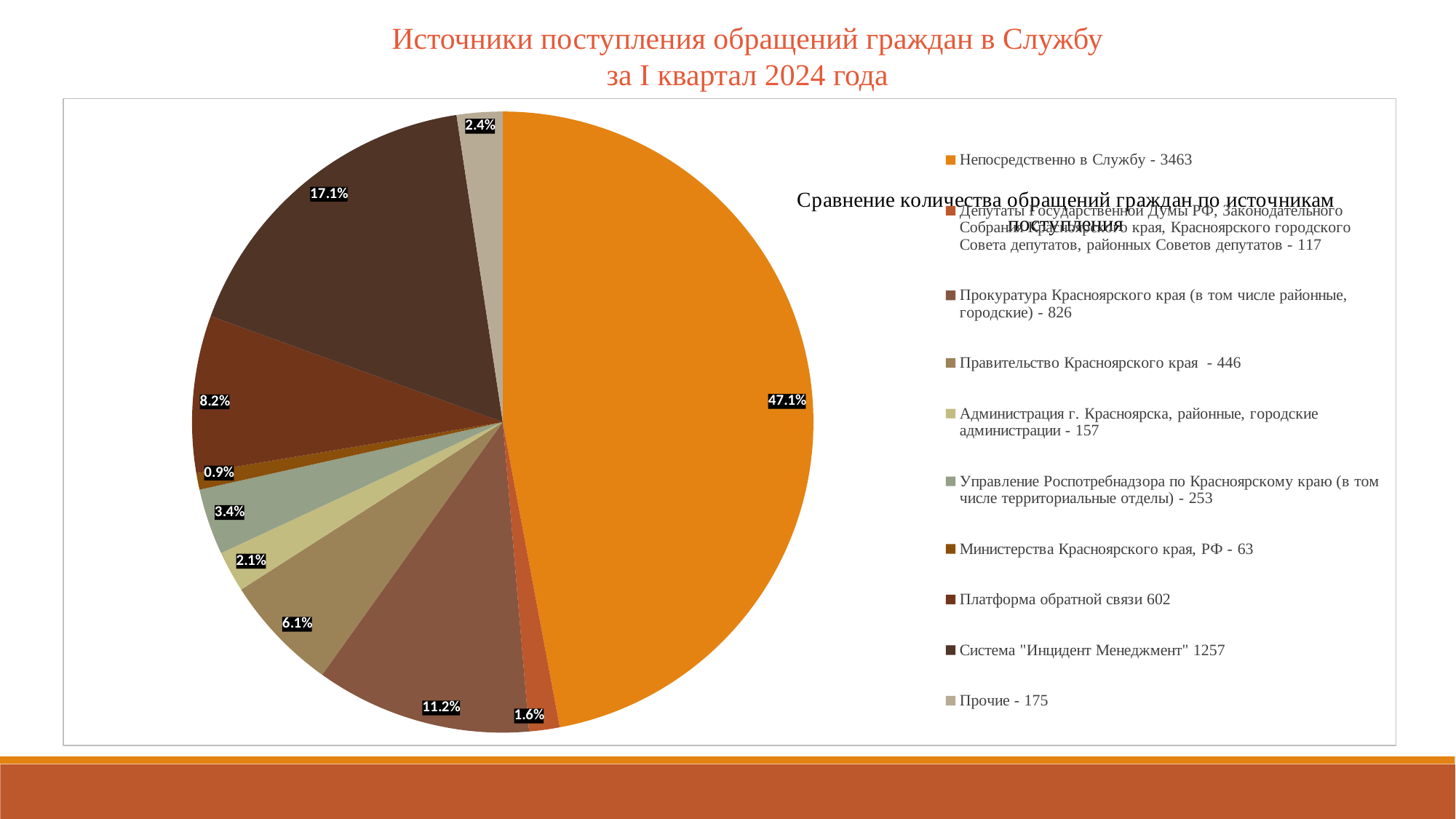
What share of the pie does "Непосредственно в Службу" account for? 47.1% What kind of chart is shown on the slide? Pie chart What share of the pie does "Прокуратура Красноярского края (в том числе районные, городские)" account for? 11.2% According to the legend, how many appeals came through "Платформа обратной связи"? 602 What share of the pie does "Система "Инцидент Менеджмент"" account for? 17.1% Which slice is larger: "Управление Роспотребнадзора по Красноярскому краю" or "Администрация г. Красноярска, районные, городские администрации"? Управление Роспотребнадзора по Красноярскому краю Which source has the smallest slice of the pie? Министерства Красноярского края, РФ What is the difference in percentage points between the "Платформа обратной связи" slice (8.2%) and the "Правительство Красноярского края" slice (6.1%)? 2.1 According to the legend, how many appeals are listed for "Прочие"? 175 How many slices does the pie chart have? 10 What is the title of the chart? Сравнение количества обращений граждан по источникам поступления Which source has the largest slice of the pie? Непосредственно в Службу